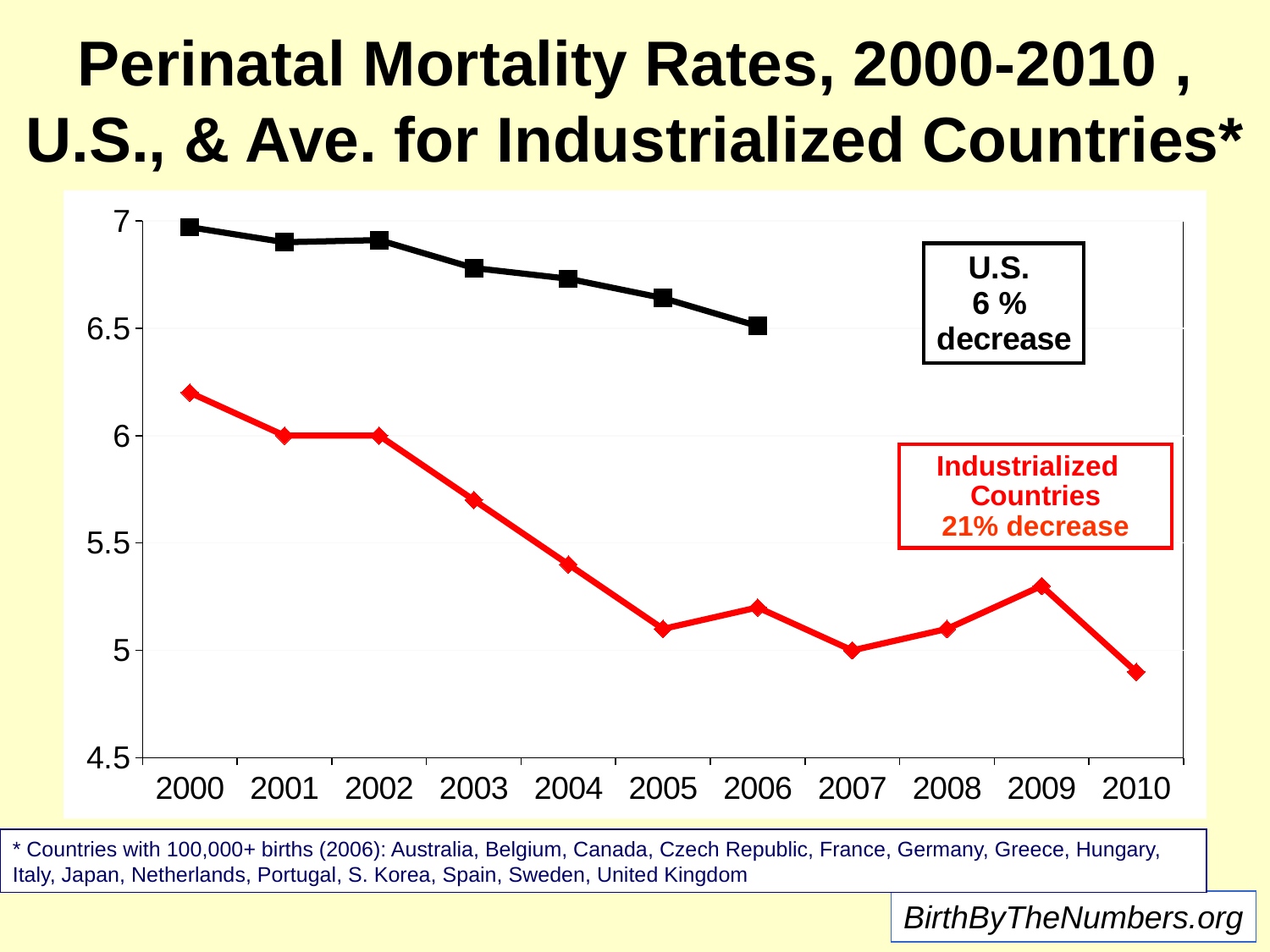
What is the value for the Industrialized Countries series in 2007? 5 In 2005, which series has the higher value, the U.S. or the Industrialized Countries? U.S. How many data series are plotted on the chart? 2 Is the value for the Industrialized Countries in 2004 greater or less than 5.5? less How many data points does the U.S. series have? 7 Does the U.S. series rise or fall from 2000 to 2006? fall What is the value for the Industrialized Countries series in 2002? 6 What kind of chart is shown on the slide? line chart Is the value for the U.S. in 2003 greater or less than 6.5? greater What percentage decrease does the chart annotation give for the Industrialized Countries? 21% decrease How many years are shown along the x axis of the chart? 11 Is the value for the Industrialized Countries in 2000 greater or less than 6? greater